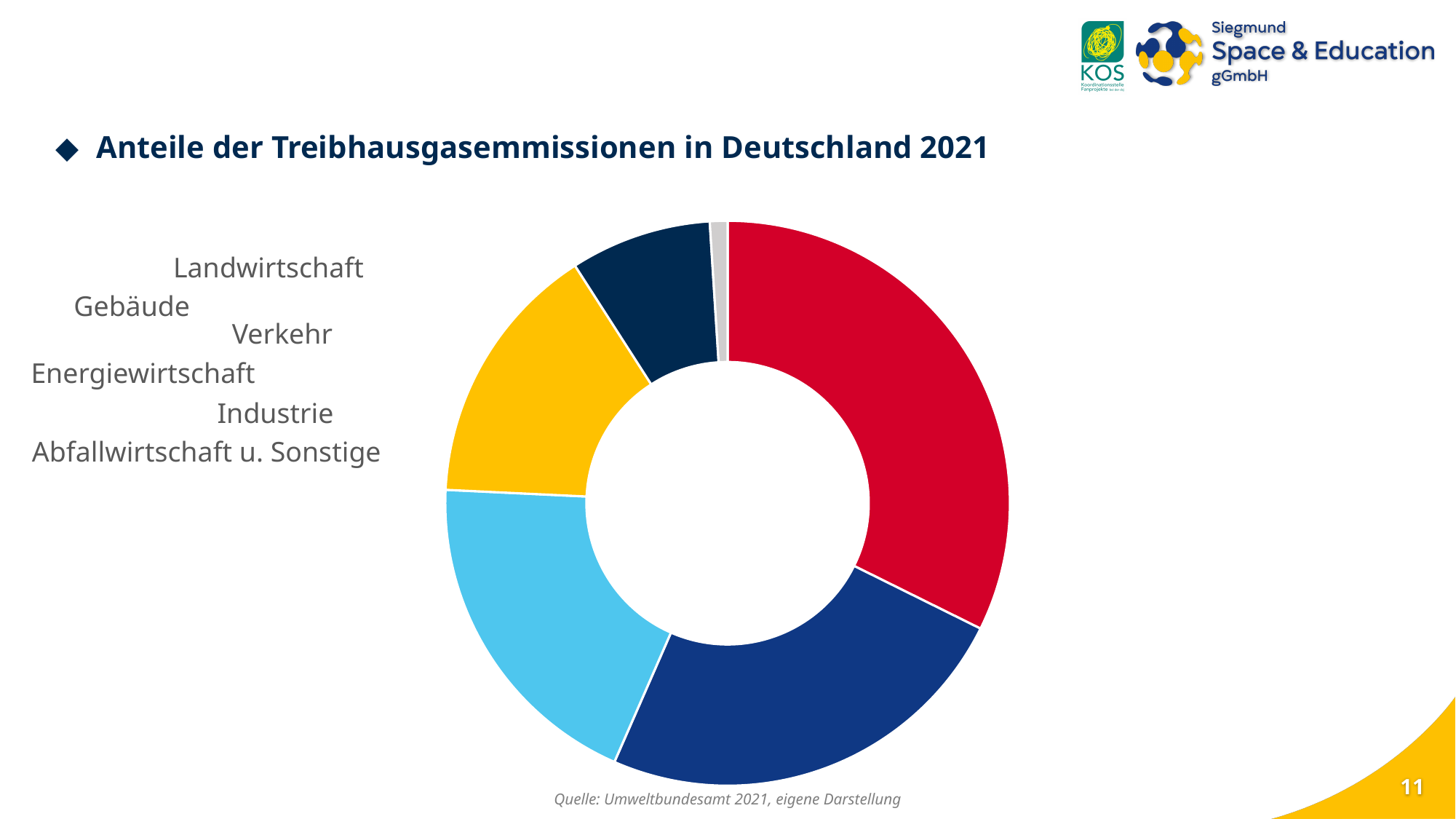
What is the title of the chart? Anteile der Treibhausgasemmissionen in Deutschland 2021 Which slice is larger, the dark blue one or the yellow one? dark blue Does the red slice account for more or less than half of the chart? less How many slices does the chart have? 6 Which slice is larger, the red one or the dark blue one? red Which colour slice is the largest in the chart? red How many categories are listed in the legend of the chart? 6 Which slice is larger, the navy one at the top or the grey one? navy What source is cited below the chart? Umweltbundesamt 2021, eigene Darstellung Which colour slice is the smallest in the chart? grey What kind of chart is shown on the slide? pie chart (donut)